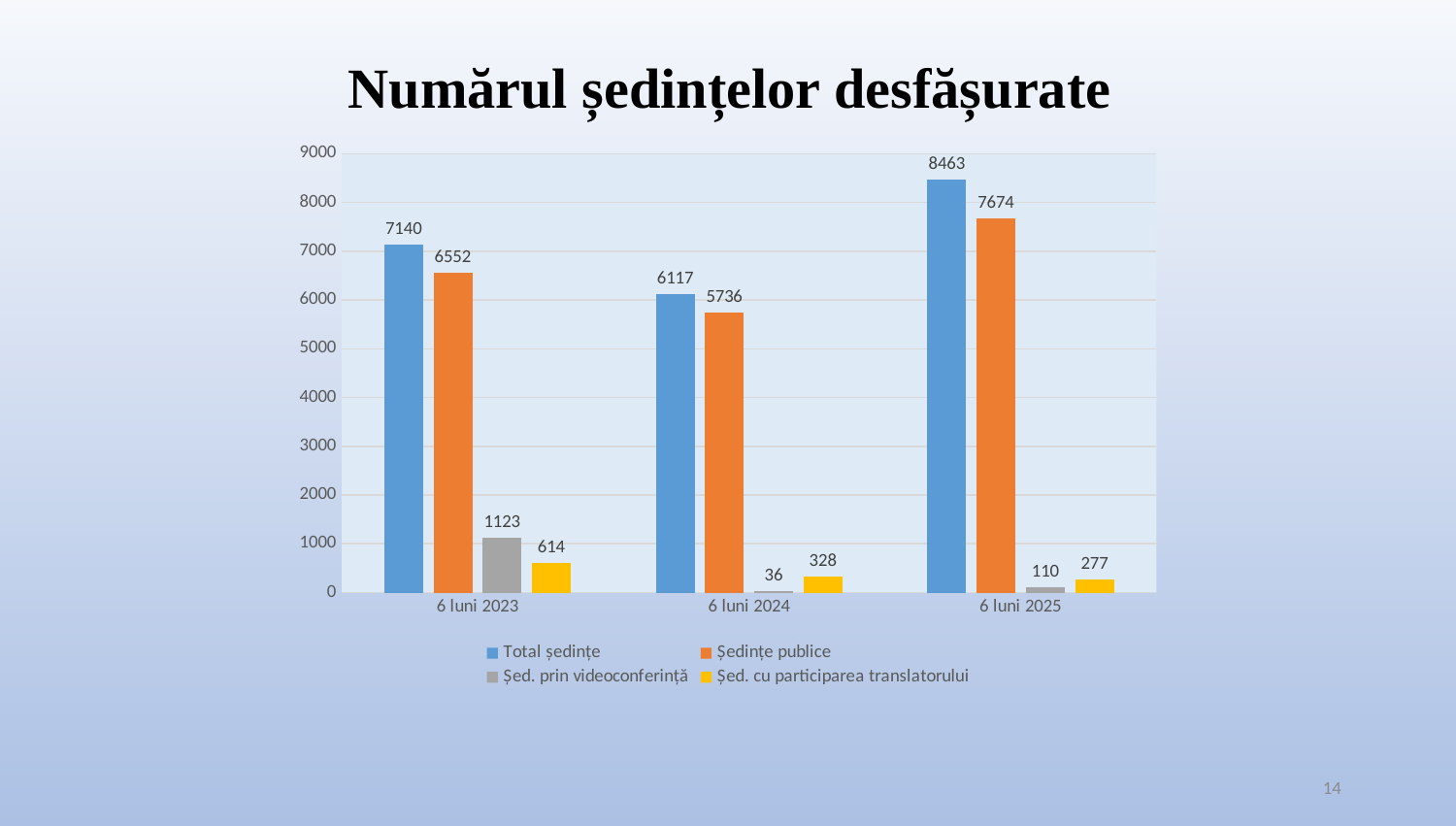
Which period has the highest value for Total ședințe? 6 luni 2025 What is the title of the chart? Numărul ședințelor desfășurate Which is larger: Șed. cu participarea translatorului for 6 luni 2023 or for 6 luni 2024? 6 luni 2023 How many series does the legend list? 4 What is the value of Ședințe publice for 6 luni 2023? 6552 What kind of chart is shown on the slide? bar chart How many periods are shown on the x axis? 3 What is the value of Șed. cu participarea translatorului for 6 luni 2025? 277 Which period has the lowest value for Șed. prin videoconferință? 6 luni 2024 What is the value of Total ședințe for 6 luni 2025? 8463 What is the difference between Total ședințe and Ședințe publice for 6 luni 2024? 381 What is the value of Șed. prin videoconferință for 6 luni 2024? 36